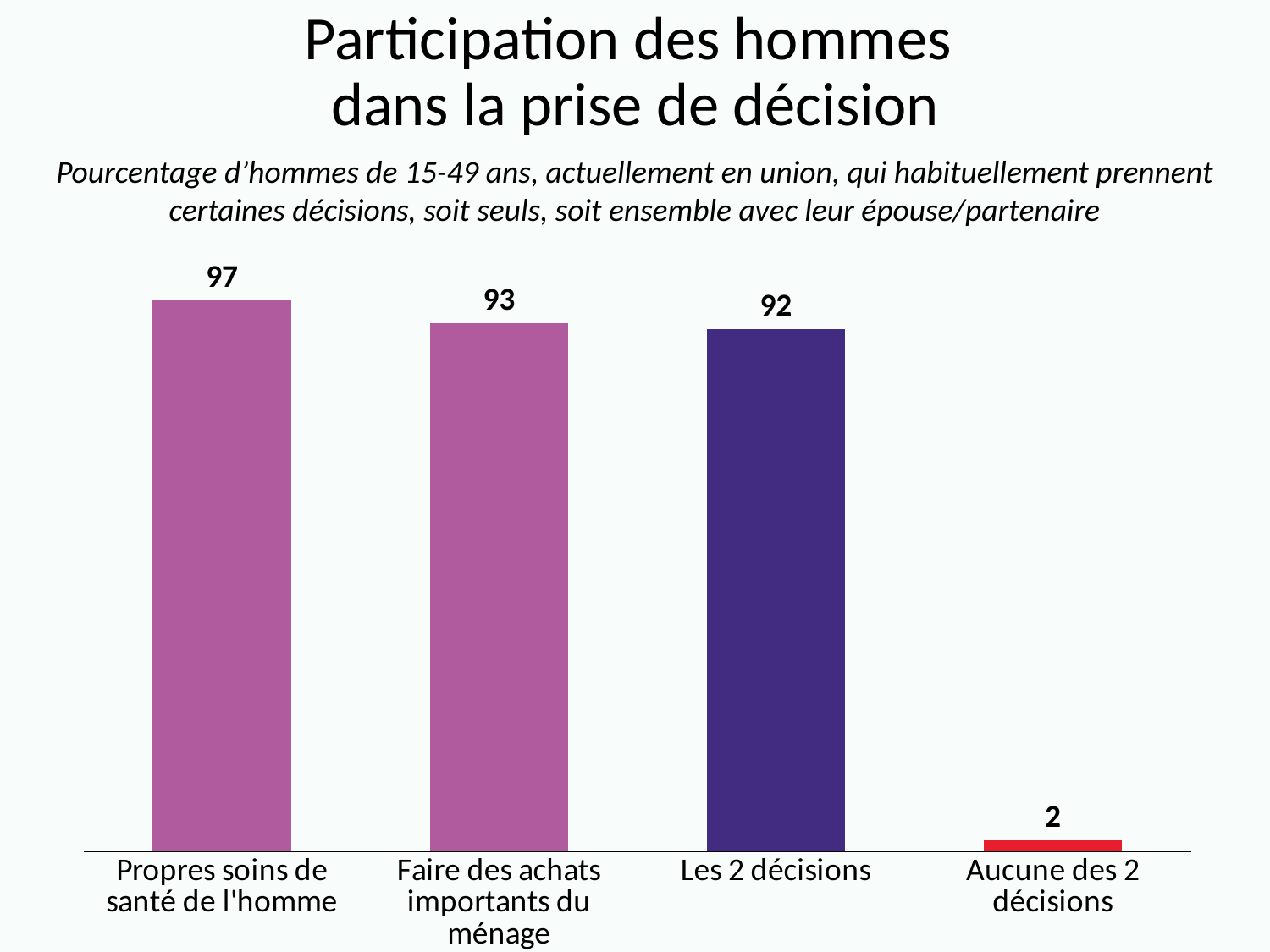
How many categories are shown in the chart? 4 What kind of chart is shown on the slide? Bar chart What is the value for "Aucune des 2 décisions"? 2 What is the difference between the values for "Propres soins de santé de l'homme" and "Les 2 décisions"? 5 What is the difference between the values for "Faire des achats importants du ménage" and "Aucune des 2 décisions"? 91 Which is larger: the value for "Propres soins de santé de l'homme" or the value for "Aucune des 2 décisions"? Propres soins de santé de l'homme Which category has the highest value? Propres soins de santé de l'homme Which category has the lowest value? Aucune des 2 décisions What is the value for "Les 2 décisions"? 92 What is the value for "Propres soins de santé de l'homme"? 97 What colour is the bar for "Les 2 décisions"? Dark purple What is the value for "Faire des achats importants du ménage"? 93